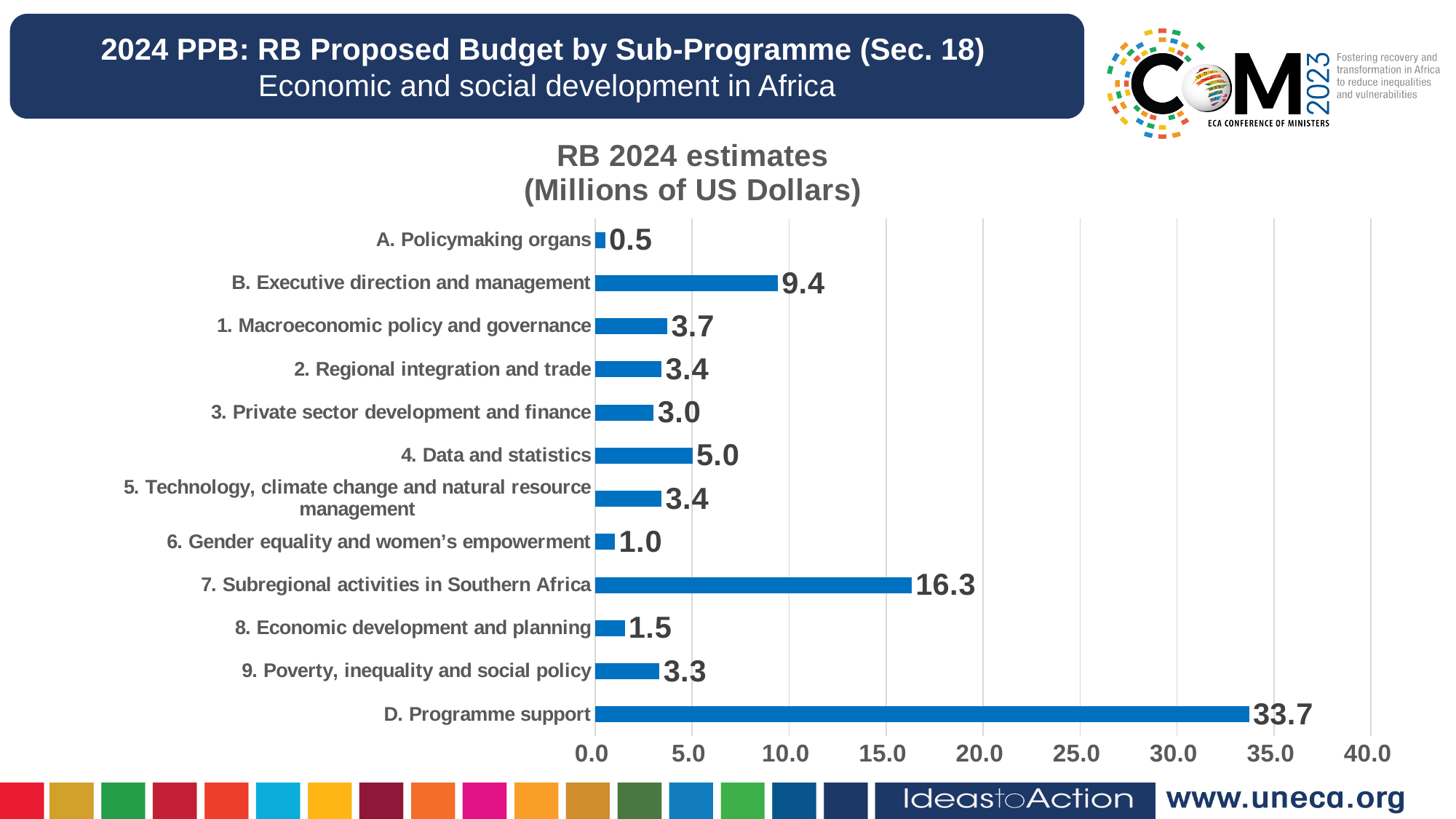
Which sub-programme has the highest RB 2024 estimate? D. Programme support What is the RB 2024 estimate for D. Programme support? 33.7 What is the title of the chart? RB 2024 estimates (Millions of US Dollars) Which has a larger RB 2024 estimate: 4. Data and statistics or 3. Private sector development and finance? 4. Data and statistics Which sub-programme has the lowest RB 2024 estimate? A. Policymaking organs What is the RB 2024 estimate for 4. Data and statistics? 5.0 How many sub-programme categories are shown in the chart? 12 What is the RB 2024 estimate for 7. Subregional activities in Southern Africa? 16.3 What type of chart is shown on the slide? bar chart What is the difference between the RB 2024 estimates for B. Executive direction and management and 1. Macroeconomic policy and governance? 5.7 What is the difference between the RB 2024 estimates for D. Programme support and 7. Subregional activities in Southern Africa? 17.4 Is the RB 2024 estimate for B. Executive direction and management greater or less than 10.0? less